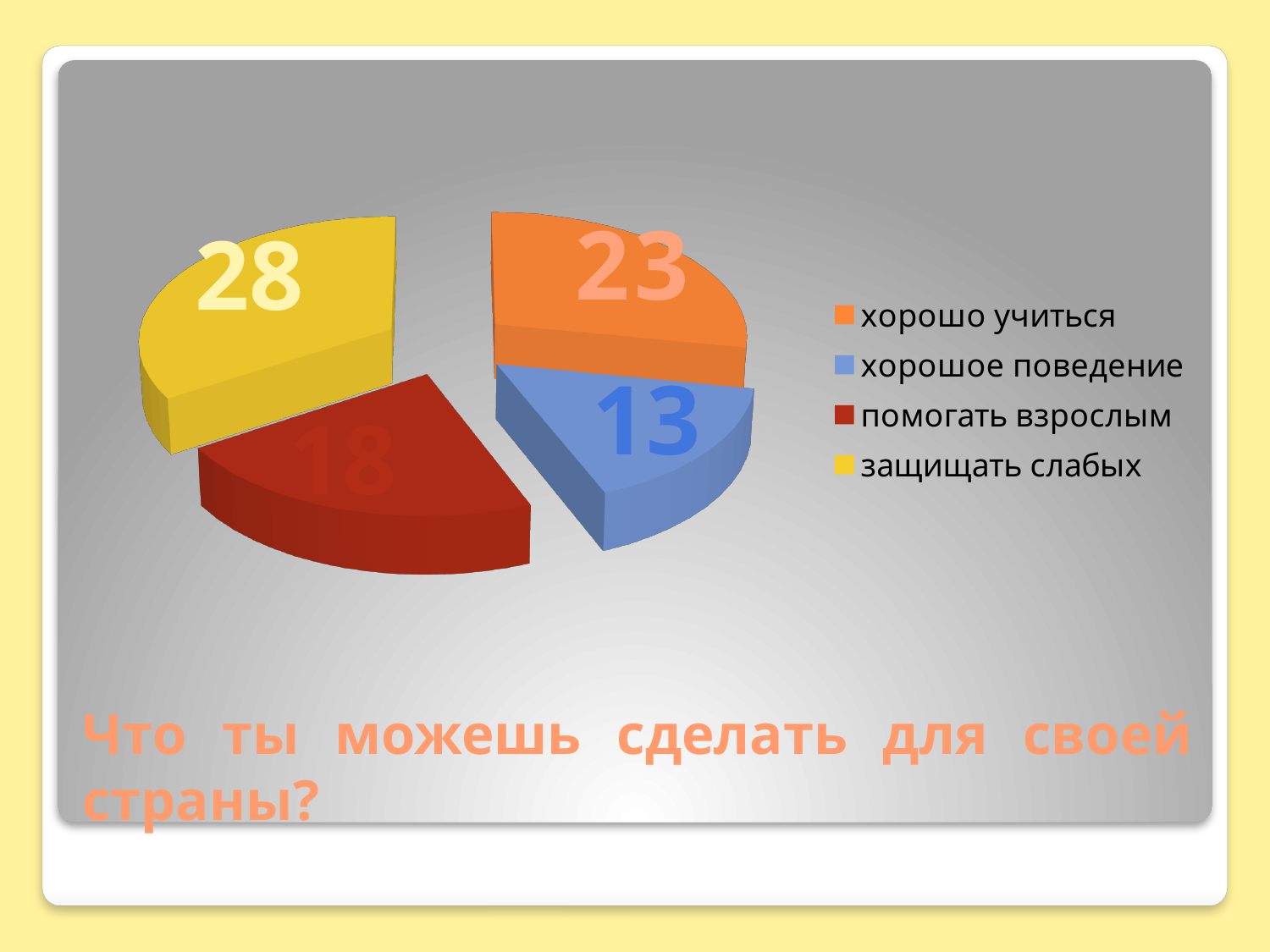
How many slices does the pie chart have? 4 What is the value for хорошо учиться? 23 Which category has the largest slice? защищать слабых What is the total of all the slice values in the pie chart? 82 What is the difference between the values for защищать слабых and хорошое поведение? 15 What colour is the slice for помогать взрослым? red Which is larger, the value for хорошо учиться or the value for помогать взрослым? хорошо учиться What kind of chart is shown on the slide? pie chart What is the value for защищать слабых? 28 Which category has the smallest slice? хорошое поведение What is the value for хорошое поведение? 13 What is the value for помогать взрослым? 18